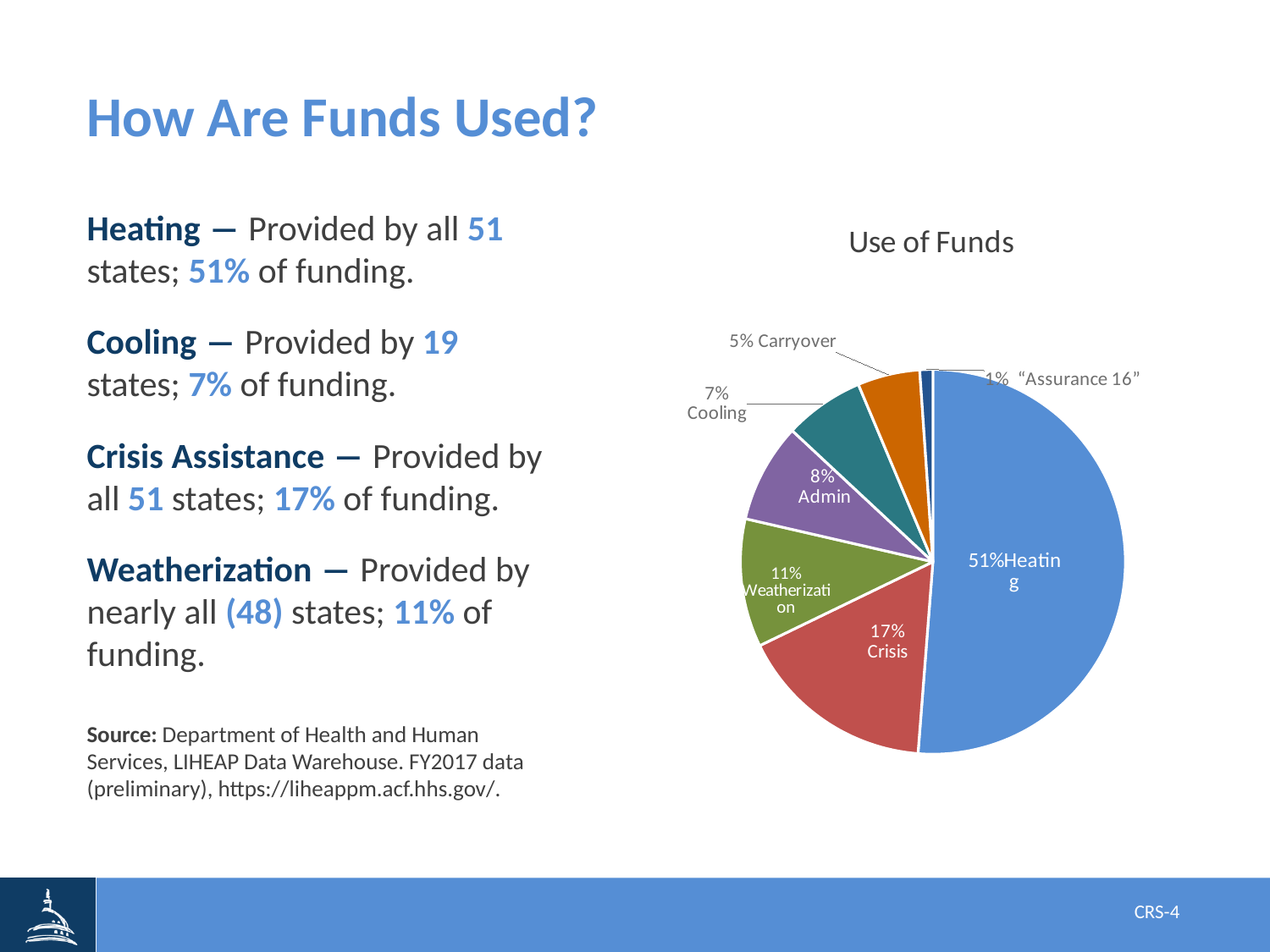
What share of funds is Carryover? 5% What share of funds goes to Admin? 8% What is the title of the chart? Use of Funds Which category has the smallest slice of the pie? "Assurance 16" What share of funds goes to Heating? 51% What kind of chart is shown on the slide? pie chart Which category has the largest slice of the pie? Heating What is the difference in percentage points between the Heating and Crisis slices? 34 How many slices does the pie chart have? 7